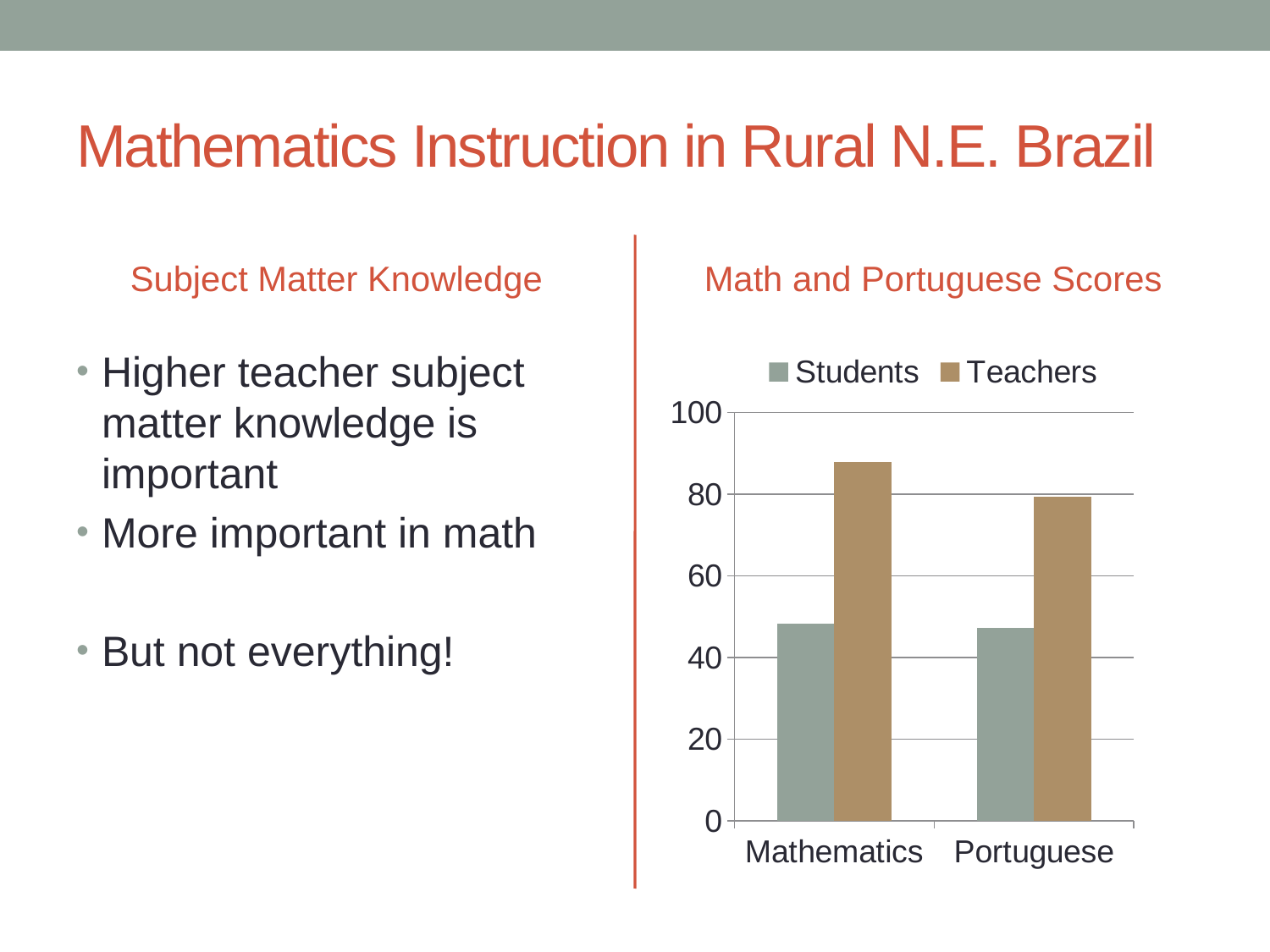
Is the Teachers value for Mathematics greater or less than 80? greater Is the Students value for Mathematics greater or less than 60? less In the Mathematics category, which series has the larger value, Students or Teachers? Teachers What is the title of the chart on the slide? Math and Portuguese Scores For the Teachers series, which category has the higher value, Mathematics or Portuguese? Mathematics Which bar in the chart is the tallest overall? Teachers, Mathematics How many categories are shown on the x axis of the chart? 2 Which series does the legend list first? Students What kind of chart is shown on the slide? bar chart Is the Students value for Portuguese greater or less than 40? greater How many series does the chart's legend list? 2